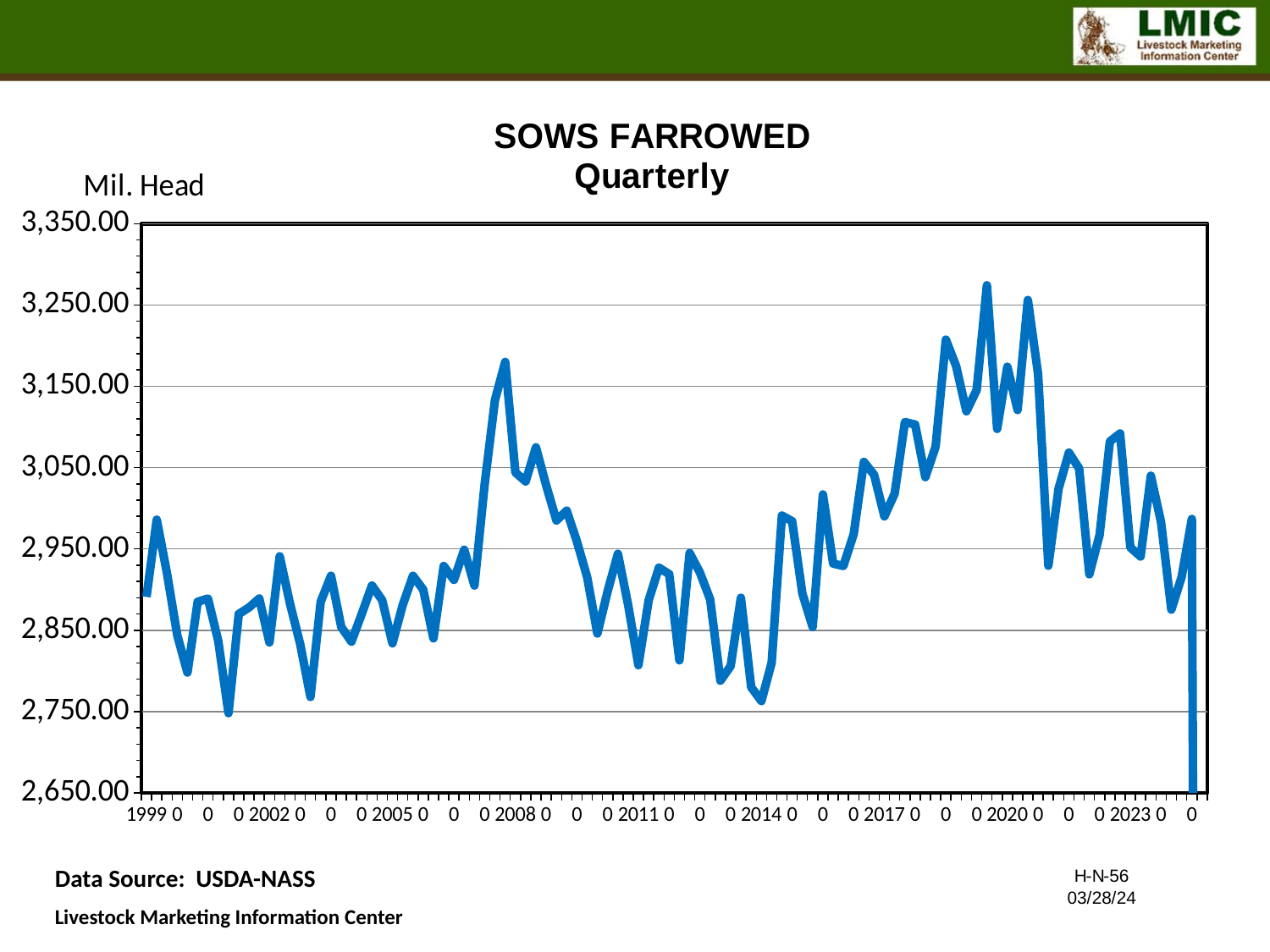
What unit is shown on the y axis of the chart? Mil. Head Is the peak around 2019 higher or lower than the peak around 2008? higher Do the values generally rise or fall between 2020 and 2023? fall How many data series are plotted on the chart? 1 What is the title of the chart? SOWS FARROWED Quarterly Is the peak value around 2008 greater or less than 3,150? greater What kind of chart is shown on the slide? line chart Do the values generally rise or fall between 2014 and 2019? rise Is the lowest value around 2014 greater or less than 2,850? less Is the value at the start of 1999 greater or less than 2,850? greater